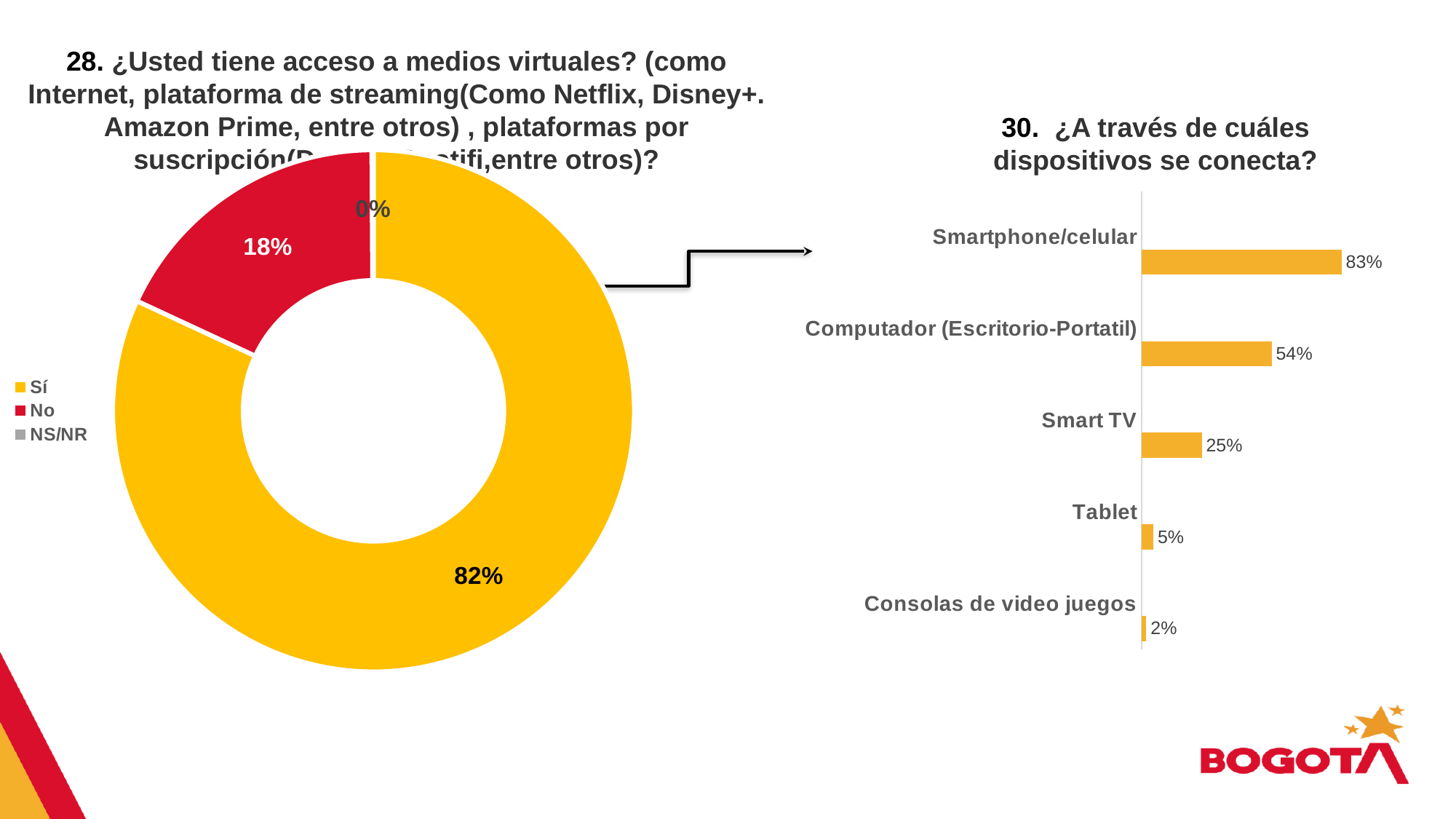
In the right chart (question 30), which device has the lowest value? Consolas de video juegos How many entries does the legend of the left chart (question 28) list? 3 In the right chart (question 30), what is the value for Computador (Escritorio-Portatil)? 54% In the right chart (question 30), what is the difference between Smart TV and Tablet? 20% In the left chart (question 28), which response has the largest share? Sí In the left chart (question 28), what percentage is shown for NS/NR? 0% In the left chart (question 28), what percentage answered Sí? 82% In the right chart (question 30), what is the value for Smartphone/celular? 83% How many categories are shown in the right chart (question 30)? 5 In the left chart (question 28), what percentage answered No? 18% What kind of chart is the left chart (question 28)? Pie chart (donut) In the left chart (question 28), what is the difference between the Sí and No shares? 64%